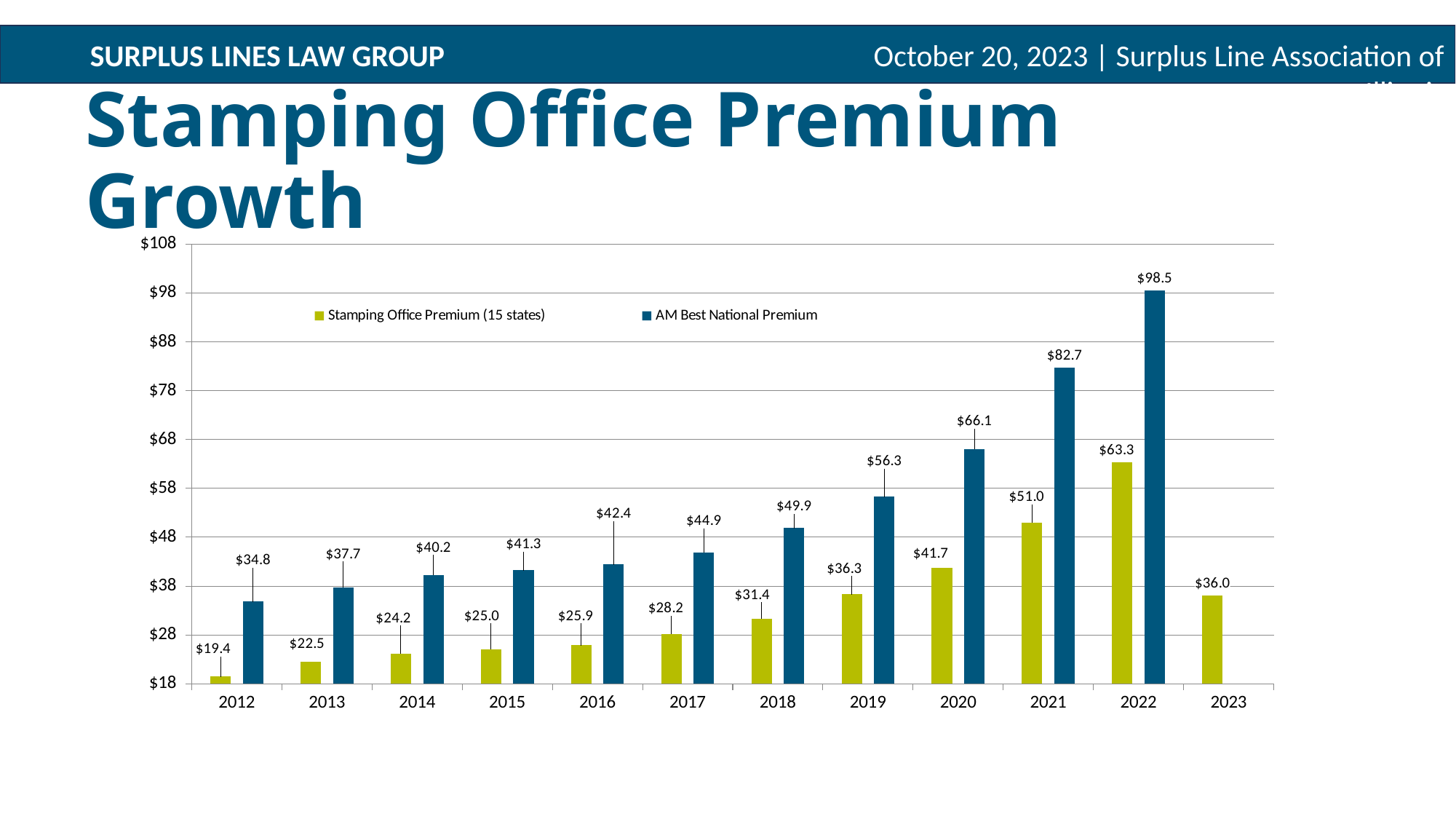
Which is larger in 2020: the Stamping Office Premium (15 states) or the AM Best National Premium? AM Best National Premium How many series does the legend list? 2 Is the AM Best National Premium value for 2018 greater or less than $48? greater What is the AM Best National Premium value for 2021? $82.7 What kind of chart is shown on the slide? Bar chart What is the difference between the AM Best National Premium and the Stamping Office Premium (15 states) in 2022? $35.2 Does the Stamping Office Premium (15 states) rise or fall from 2012 to 2022? Rise What colour are the AM Best National Premium bars? Dark blue How many years are shown on the x axis? 12 Which year has the highest AM Best National Premium value? 2022 Which year has the lowest Stamping Office Premium (15 states) value? 2012 What is the Stamping Office Premium (15 states) value for 2019? $36.3